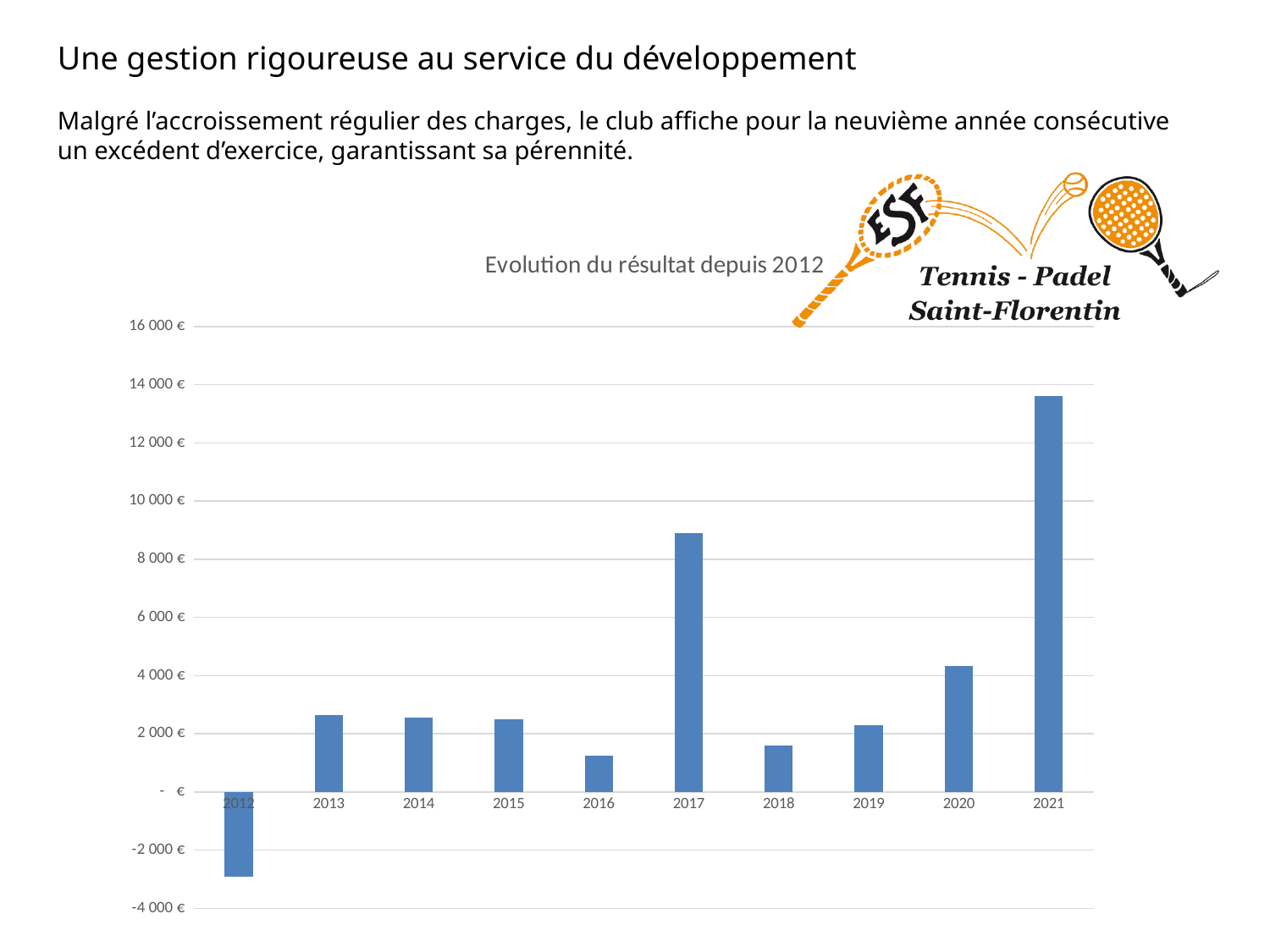
Is the value for 2021 greater or less than 12 000 €? greater What type of chart is shown on the slide? bar chart How many years are plotted on the chart? 10 Which year has the lowest value on the chart? 2012 What is the title of the chart? Evolution du résultat depuis 2012 Which year has the larger value, 2018 or 2019? 2019 Which year has the highest value on the chart? 2021 Is the value for 2017 greater or less than 8 000 €? greater Which year has the larger value, 2017 or 2020? 2017 Is the value for 2020 greater or less than 4 000 €? greater